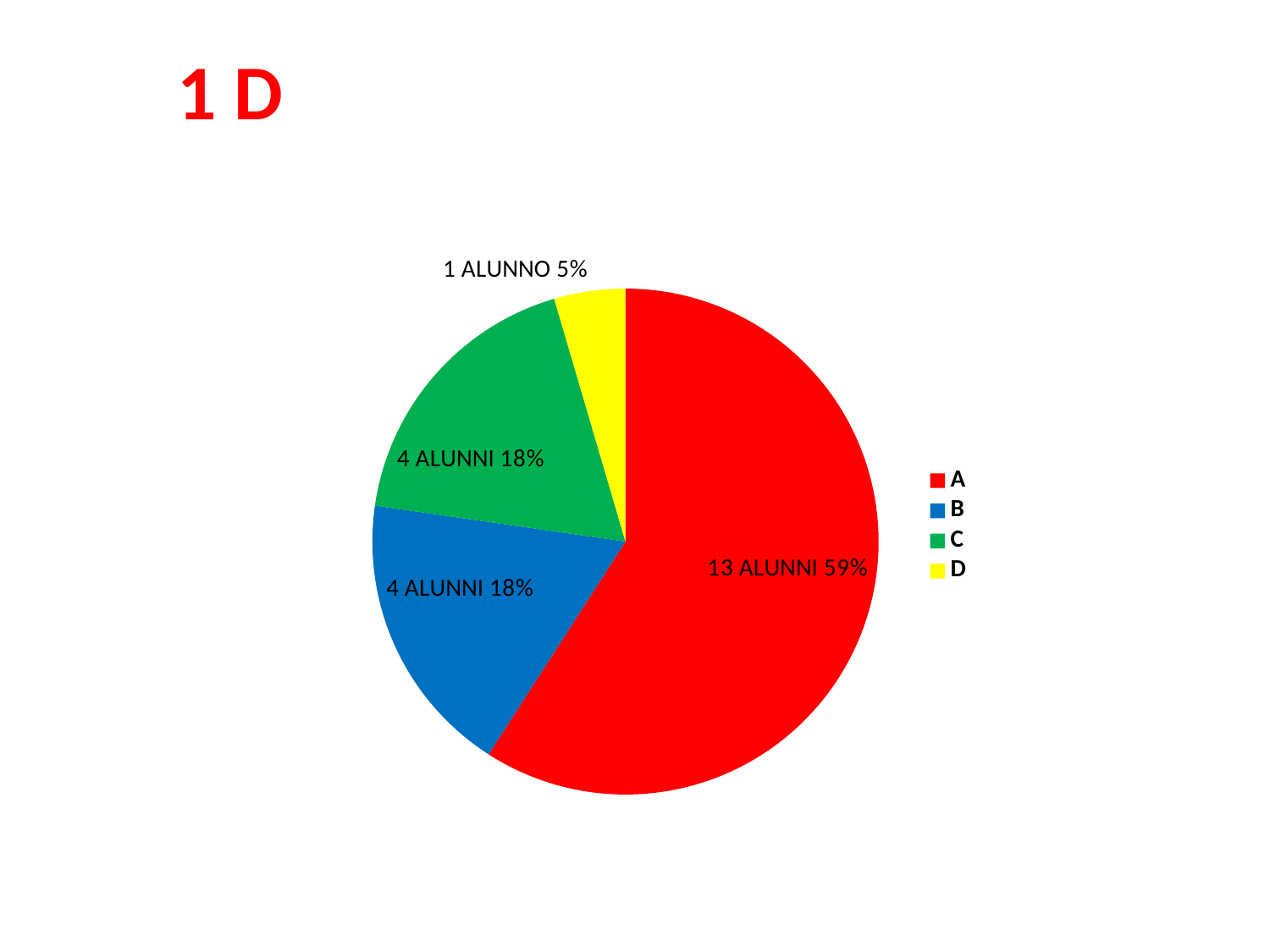
Which category has the smallest slice? D How many entries does the legend list? 4 What kind of chart is shown on the slide? pie chart How many alunni are in category C? 4 ALUNNI Which is larger, the slice for A or the slice for B? A Which category has the largest slice? A How many alunni are in category A? 13 ALUNNI What colour is the slice for category C? green How many slices does the pie chart have? 4 What share of the pie does category D have? 5% What is the difference in number of alunni between category A and category B? 9 What share of the pie does category A have? 59%